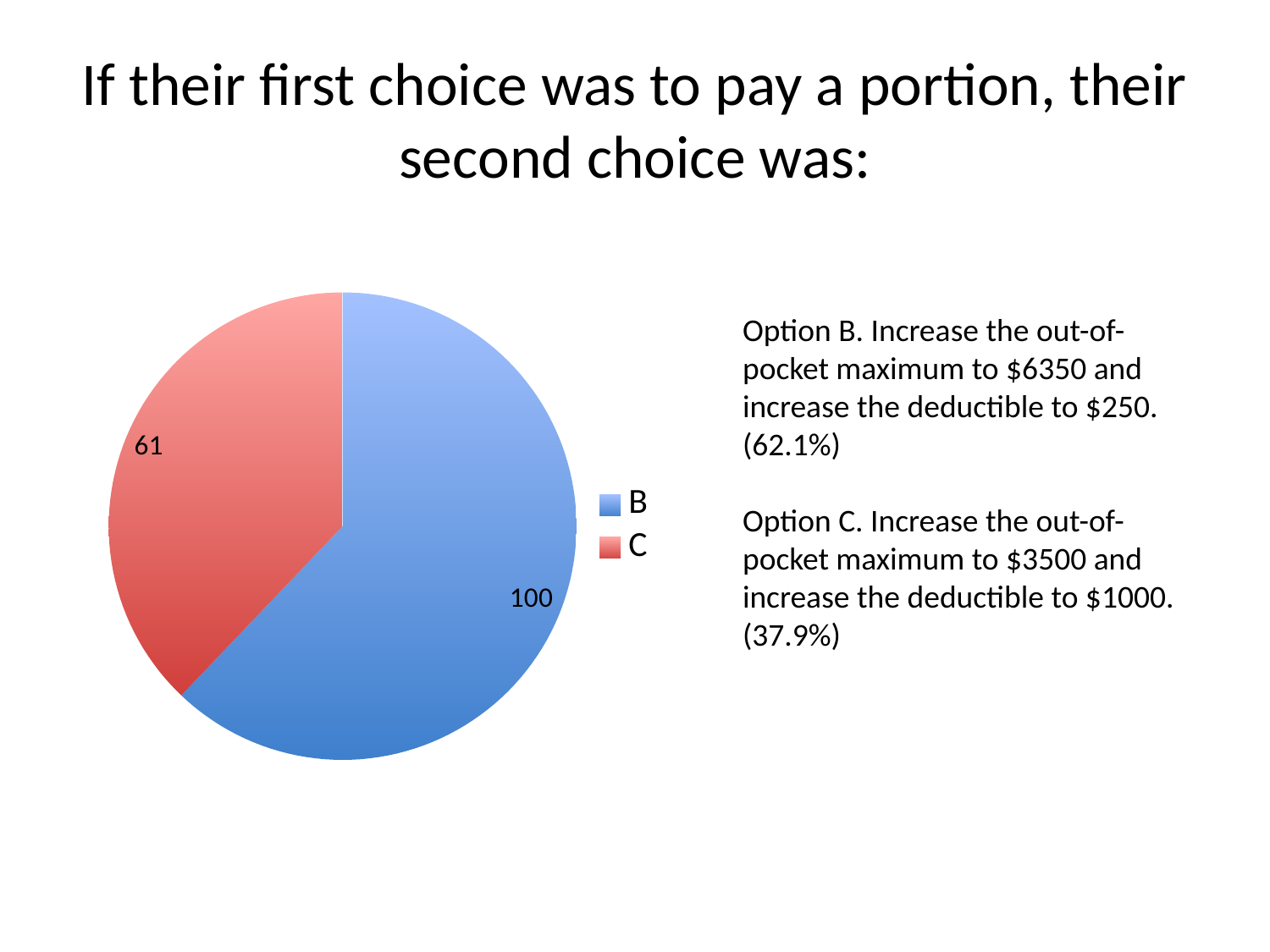
How many entries does the legend of the pie chart list? 2 What is the value for slice C in the pie chart? 61 Which slice of the pie chart is the smallest? C What is the total of the two slices in the pie chart? 161 What is the value for slice B in the pie chart? 100 Which slice of the pie chart is the largest? B What kind of chart is shown on the slide? pie chart What is the difference between the values for B and C in the pie chart? 39 What colour is slice B in the pie chart? blue Which is larger in the pie chart, B or C? B What colour is slice C in the pie chart? red How many slices does the pie chart have? 2